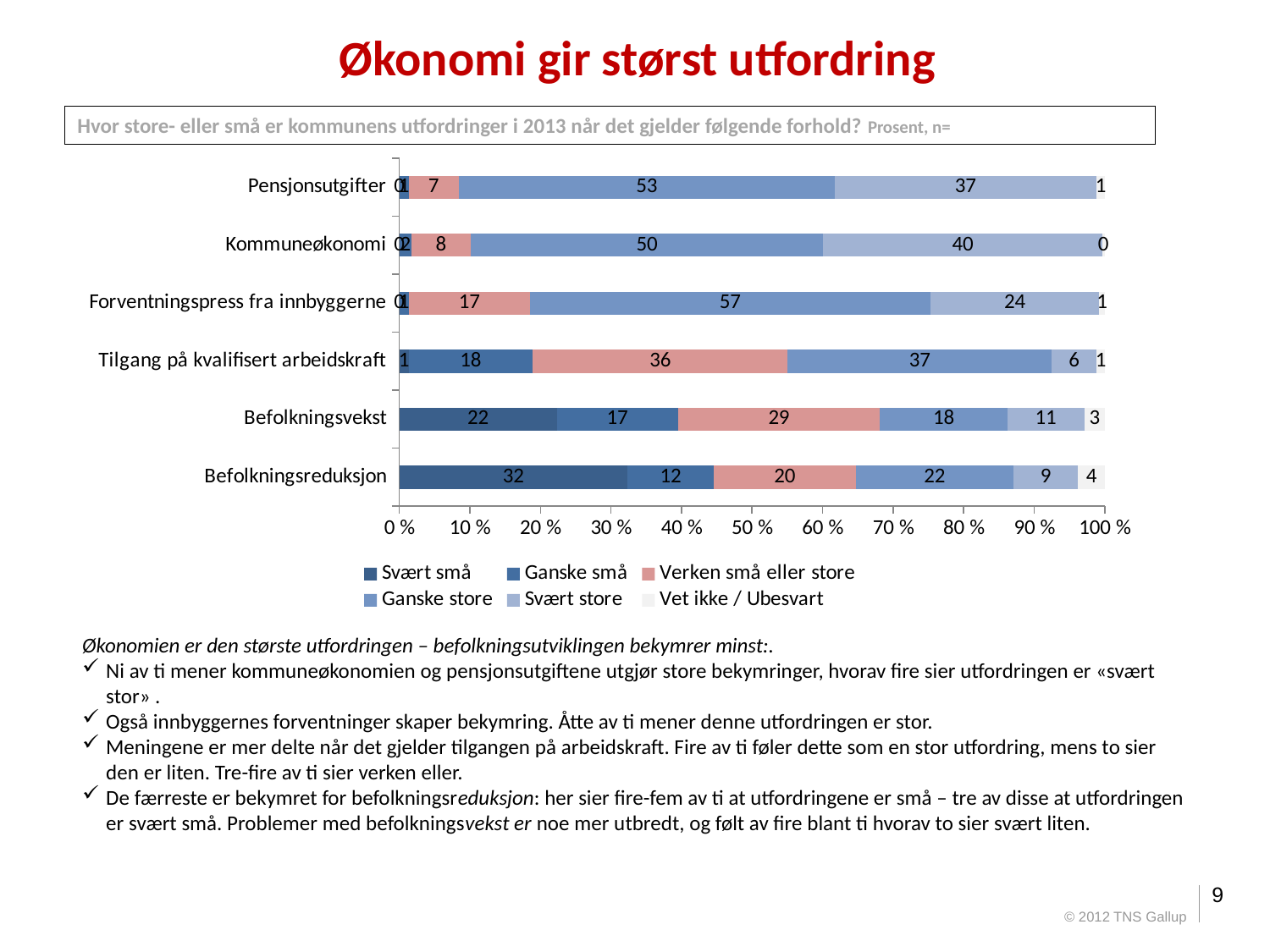
What is the difference between the "Verken små eller store" values for Forventningspress fra innbyggerne and Pensjonsutgifter? 10 What is the value of the "Verken små eller store" segment for Befolkningsvekst? 29 What is the value of the "Svært store" segment for Kommuneøkonomi? 40 What percentage of respondents answered "Ganske store" for Pensjonsutgifter? 53 How many series does the legend list? 6 What is the value of the "Svært små" segment for Befolkningsreduksjon? 32 How many categories are shown on the chart? 6 Which has the larger "Verken små eller store" value: Tilgang på kvalifisert arbeidskraft or Befolkningsreduksjon? Tilgang på kvalifisert arbeidskraft What kind of chart is shown on the slide? Stacked bar chart Which category has the highest "Ganske store" value? Forventningspress fra innbyggerne How much larger is the "Svært store" value for Kommuneøkonomi than for Pensjonsutgifter? 3 Which category has the highest "Svært små" value? Befolkningsreduksjon